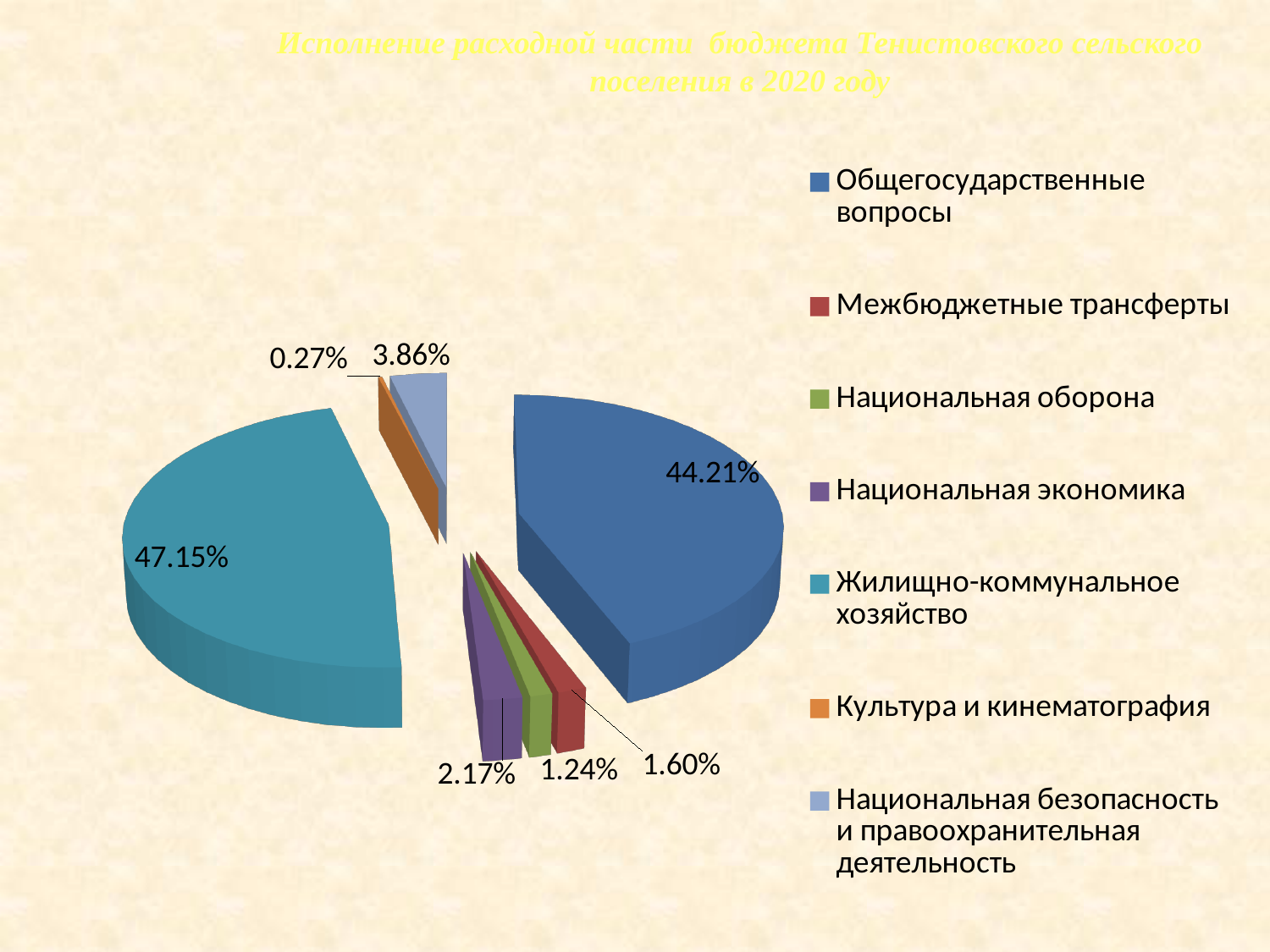
What kind of chart is shown on the slide? Pie chart What share of the pie does Общегосударственные вопросы have? 44.21% Which category has the smallest share of the pie? Культура и кинематография What is the value shown for Национальная экономика? 2.17% What is the value shown for Национальная безопасность и правоохранительная деятельность? 3.86% Which category has the largest share of the pie? Жилищно-коммунальное хозяйство How many categories does the legend list? 7 What colour is the slice for Национальная экономика? Purple What is the difference between the shares of Жилищно-коммунальное хозяйство and Общегосударственные вопросы? 2.94% What is the value shown for Культура и кинематография? 0.27% What share of the pie does Жилищно-коммунальное хозяйство have? 47.15% Which is larger: the share for Межбюджетные трансферты or the share for Национальная оборона? Межбюджетные трансферты